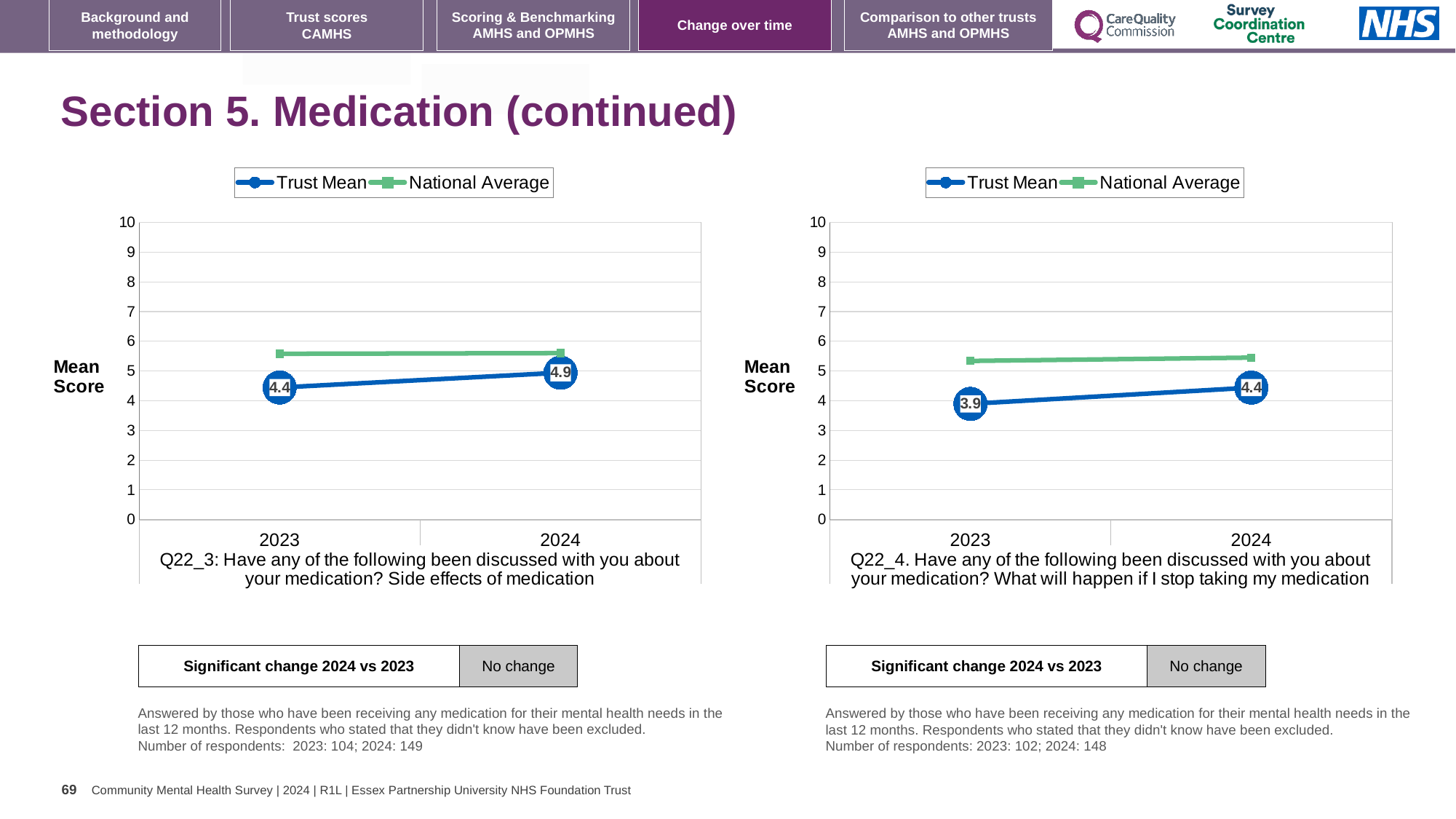
In the right chart (Q22_4), what is the Trust Mean for 2023? 3.9 How many series does the legend of the right chart (Q22_4) list? 2 In the left chart (Q22_3), which is higher in 2023, the Trust Mean or the National Average? National Average What type of chart is used for Q22_3 on the left? line chart In the left chart (Q22_3), is the National Average for 2024 greater or less than 5? greater In the right chart (Q22_4), does the Trust Mean rise or fall from 2023 to 2024? rise How many years are plotted on the x axis of the left chart (Q22_3)? 2 In the left chart (Q22_3), what is the Trust Mean for 2023? 4.4 In the right chart (Q22_4), what is the Trust Mean for 2024? 4.4 In the left chart (Q22_3), what is the Trust Mean for 2024? 4.9 In the left chart (Q22_3), by how much did the Trust Mean change from 2023 to 2024? 0.5 In the right chart (Q22_4), what is the difference between the Trust Mean in 2024 and in 2023? 0.5